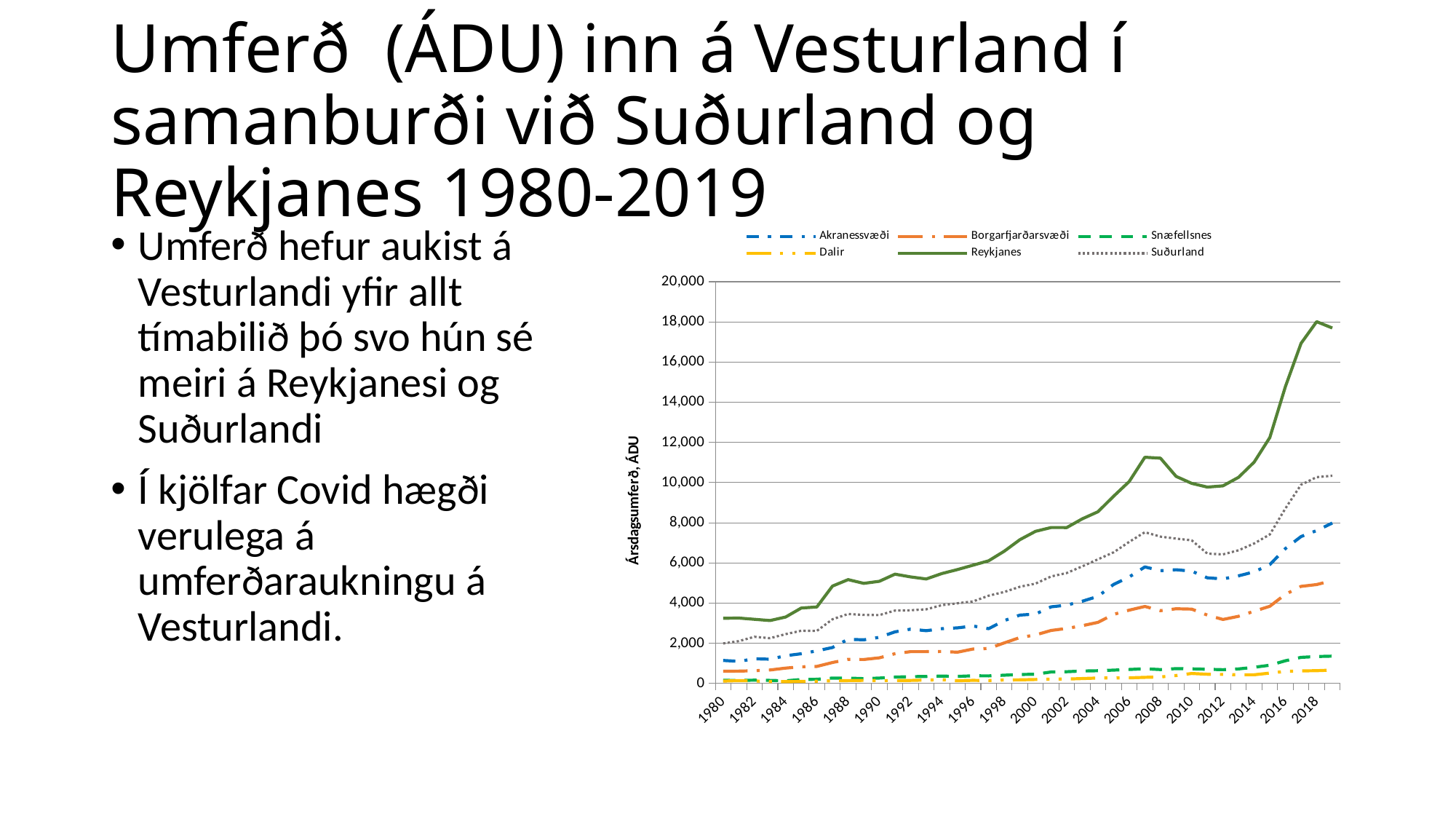
Is the value for Borgarfjarðarsvæði in 2018 greater or less than 4,000? greater Is the value for Reykjanes in 1980 greater or less than 4,000? less Which series has the lowest values across the chart? Dalir Which is larger in 2008, the value for Reykjanes or the value for Suðurland? Reykjanes Is the value for Reykjanes in 2018 greater or less than 16,000? greater Which series has the highest value in 2018? Reykjanes How many series does the chart legend list? 6 What kind of chart is shown on the slide? line chart What is the label on the vertical axis of the chart? Ársdagsumferð, ÁDU Does the Reykjanes series generally rise or fall from 1980 to 2018? rise